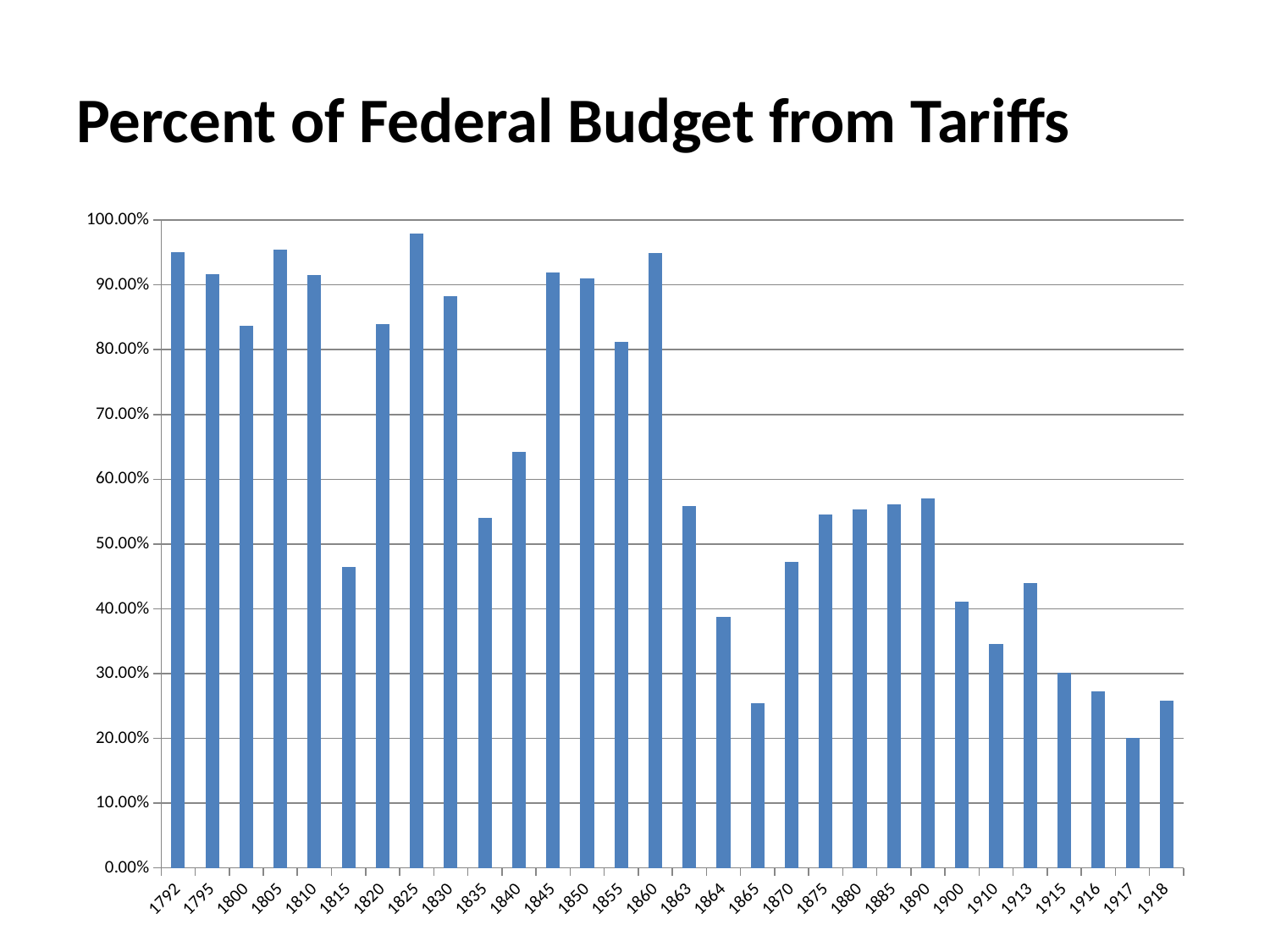
Is the value for 1815 greater or less than 50.00%? less What kind of chart is shown on the slide? bar chart Is the value for 1860 greater or less than 90.00%? greater Which is larger, the value for 1792 or the value for 1918? 1792 What is the title of the chart? Percent of Federal Budget from Tariffs Is the value for 1840 greater or less than 60.00%? greater Which is larger, the value for 1864 or the value for 1865? 1864 Which year has the highest percent of federal budget from tariffs? 1825 How many years (categories) are plotted on the x axis? 30 Which year has the lowest percent of federal budget from tariffs? 1917 Overall, do the values rise or fall from 1792 to 1918? fall